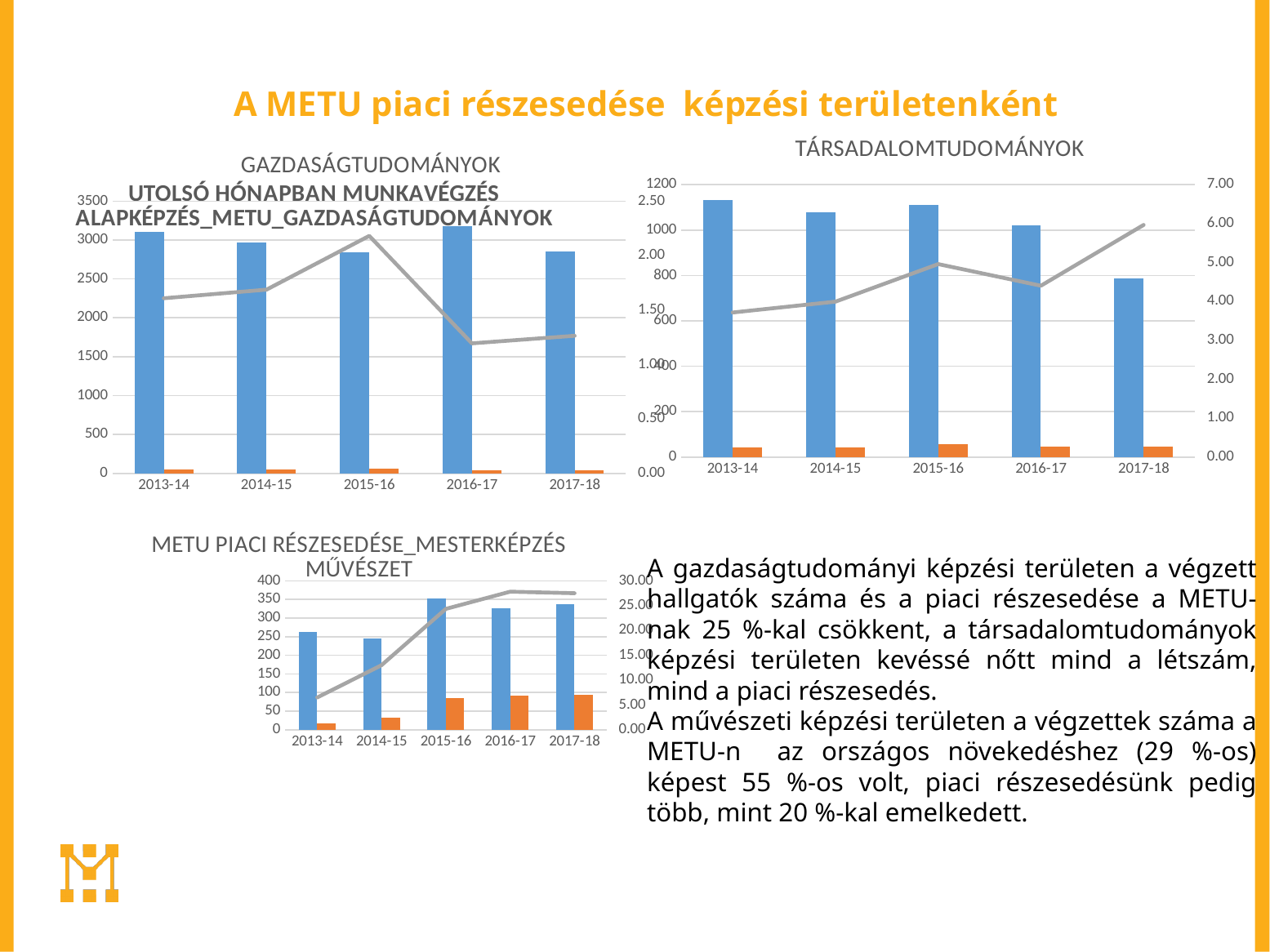
In the TÁRSADALOMTUDOMÁNYOK chart, does the grey line overall rise or fall from 2013-14 to 2017-18? rise In the METU PIACI RÉSZESEDÉSE_MESTERKÉPZÉS MŰVÉSZET chart, which year has the tallest blue bar? 2015-16 In the TÁRSADALOMTUDOMÁNYOK chart, is the blue bar for 2017-18 greater or less than 1000? less In the GAZDASÁGTUDOMÁNYOK chart, which year has the tallest blue bar? 2016-17 How many categories (academic years) are shown on the x axis of the GAZDASÁGTUDOMÁNYOK chart? 5 In the METU PIACI RÉSZESEDÉSE_MESTERKÉPZÉS MŰVÉSZET chart, which blue bar is taller, 2014-15 or 2015-16? 2015-16 In the TÁRSADALOMTUDOMÁNYOK chart, which year has the shortest blue bar? 2017-18 In the METU PIACI RÉSZESEDÉSE_MESTERKÉPZÉS MŰVÉSZET chart, which year has the shortest orange bar? 2013-14 In the GAZDASÁGTUDOMÁNYOK chart, is the blue bar for 2015-16 greater or less than 3000? less In the GAZDASÁGTUDOMÁNYOK chart, is the blue bar for 2013-14 greater or less than 3000? greater What kind of chart is the TÁRSADALOMTUDOMÁNYOK chart? bar chart with a line